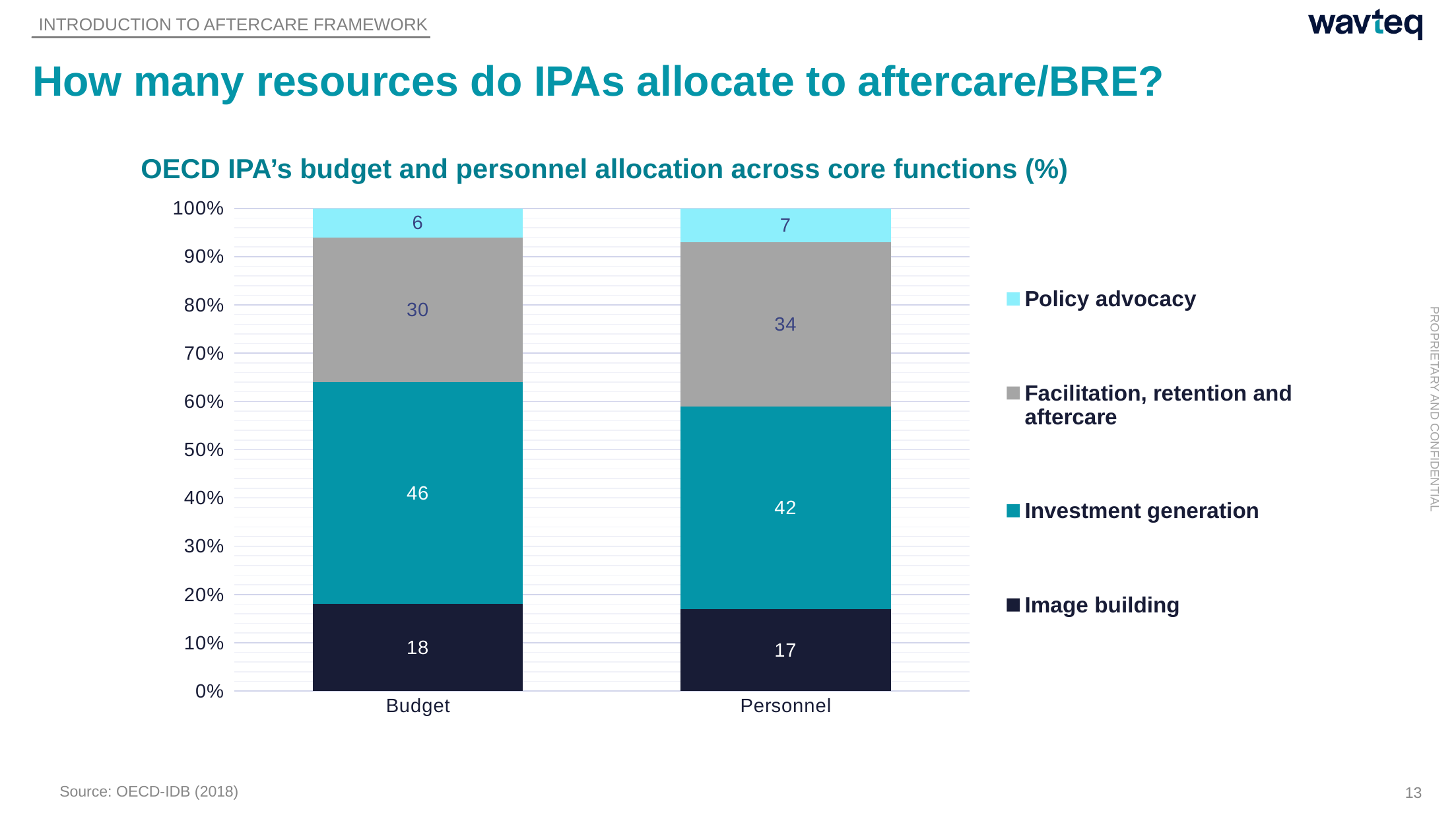
How many categories are shown on the x axis? 2 What is the value for Policy advocacy in the Budget bar? 6 Which function has the smallest share in the Personnel bar? Policy advocacy How many series does the legend list? 4 Which function has the largest share in the Budget bar? Investment generation What is the title of the chart? OECD IPA's budget and personnel allocation across core functions (%) What is the difference between the Investment generation values for Budget and Personnel? 4 What is the value for Facilitation, retention and aftercare in the Personnel bar? 34 Which is larger: Facilitation, retention and aftercare for Budget or for Personnel? Personnel What is the value for Image building in the Personnel bar? 17 What is the value for Investment generation in the Budget bar? 46 What kind of chart is shown on the slide? Stacked bar chart